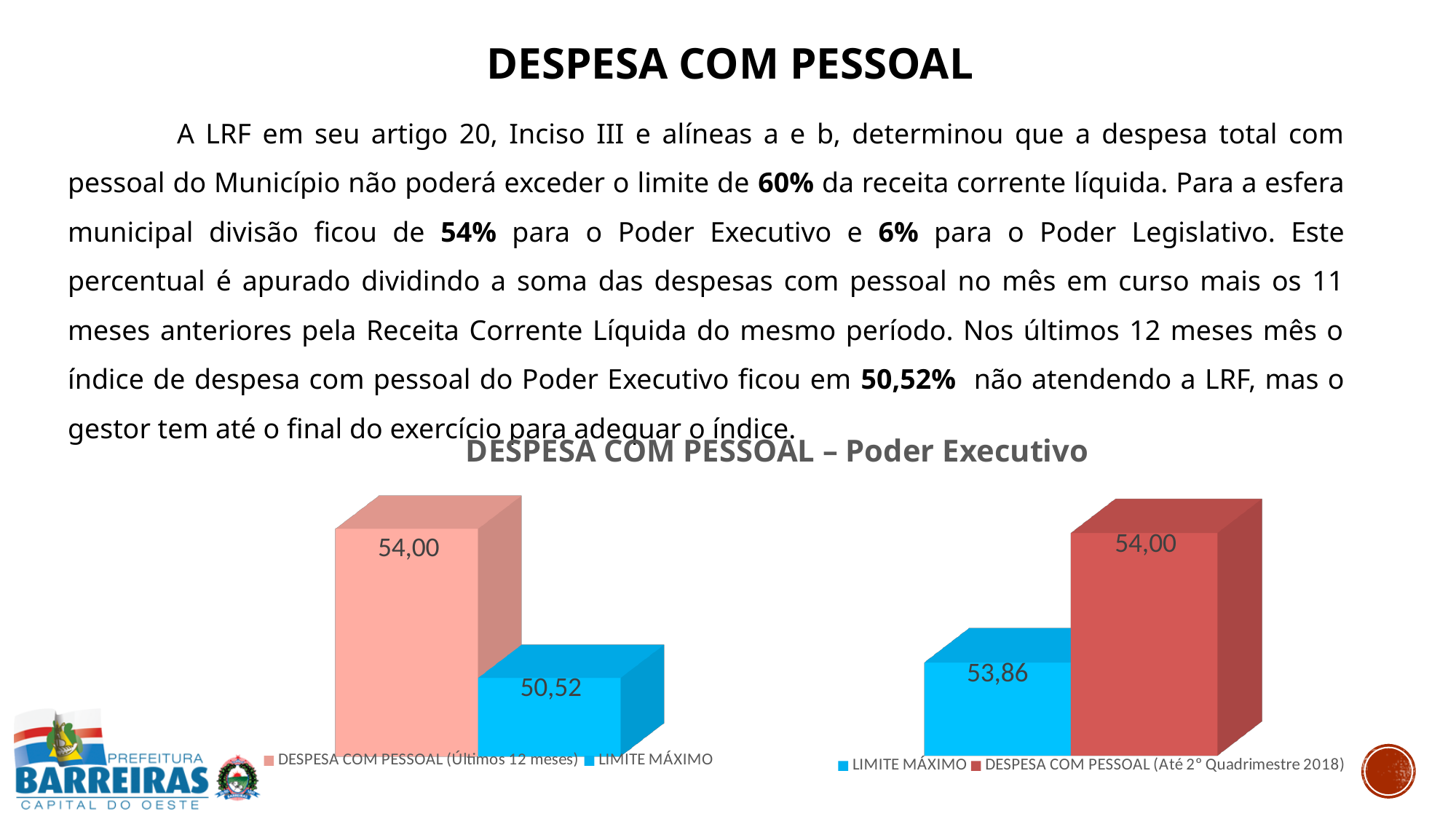
In the right chart, what value is shown on the red bar? 54,00 What is the title shown above the two charts? DESPESA COM PESSOAL – Poder Executivo In the left chart, what is the difference between the pink bar and the blue bar? 3,48 What type of chart is the left chart? bar chart In the left chart, which bar is taller, the pink one or the blue one? the pink one How many series does the legend of the right chart list? 2 How many bars are plotted in the left chart? 2 In the right chart, which bar is taller, the red one or the blue one? the red one In the right chart, what value is shown on the blue bar? 53,86 In the left chart, what value is shown on the blue bar? 50,52 In the left chart, what value is shown on the pink bar? 54,00 In the right chart, what is the difference between the red bar and the blue bar? 0,14